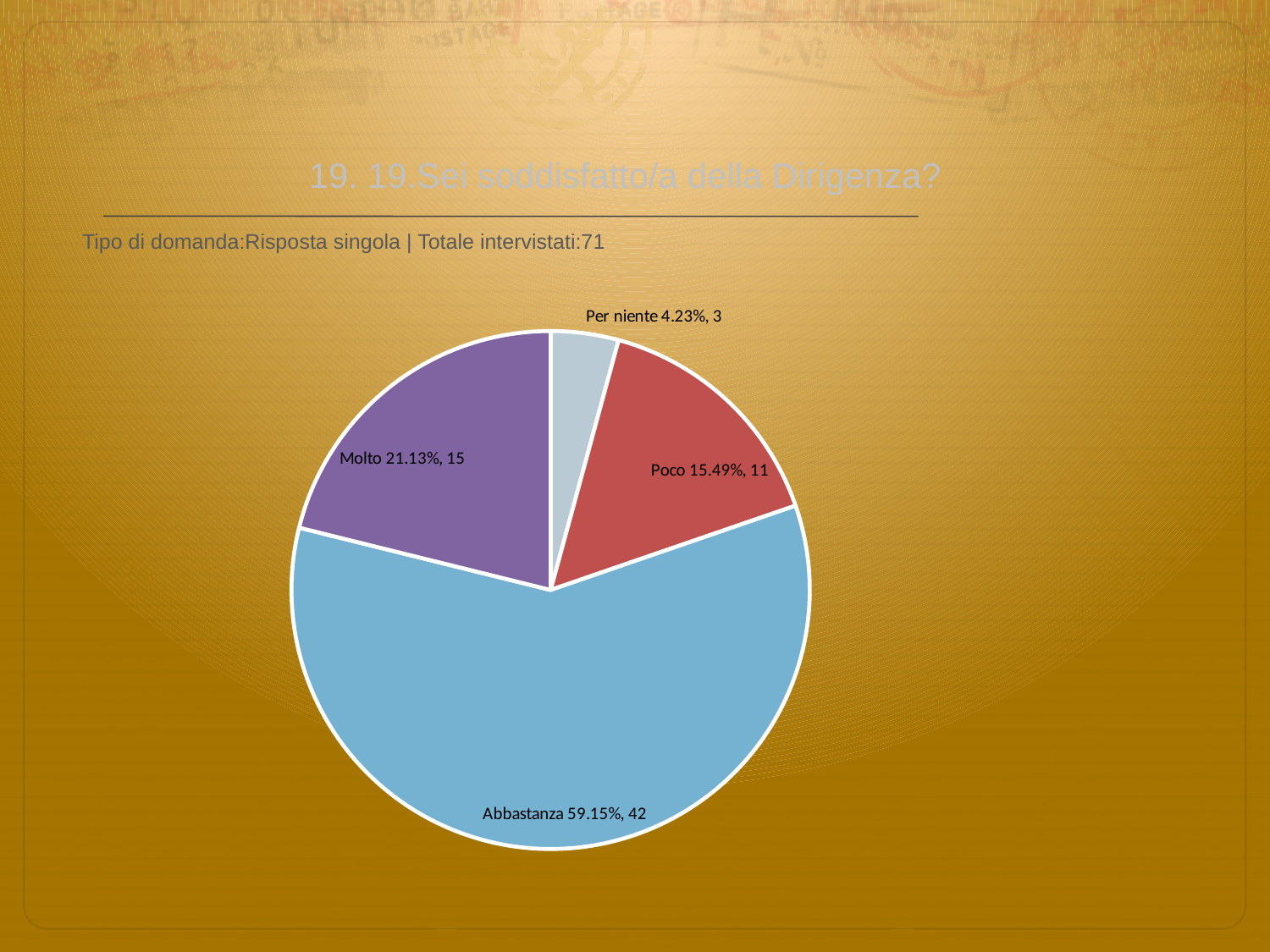
What percentage share does the 'Abbastanza' slice have? 59.15% How many slices does the pie chart have? 4 What is the total number of respondents shown on the slide? 71 Which category has the largest slice of the pie? Abbastanza What colour is the 'Abbastanza' slice? light blue How many respondents answered 'Molto'? 15 What percentage share does the 'Per niente' slice have? 4.23% What kind of chart is shown on the slide? pie chart Which category has the smallest slice of the pie? Per niente Which has more respondents, 'Molto' or 'Poco'? Molto What is the difference in respondent count between 'Abbastanza' and 'Molto'? 27 How many respondents answered 'Poco'? 11